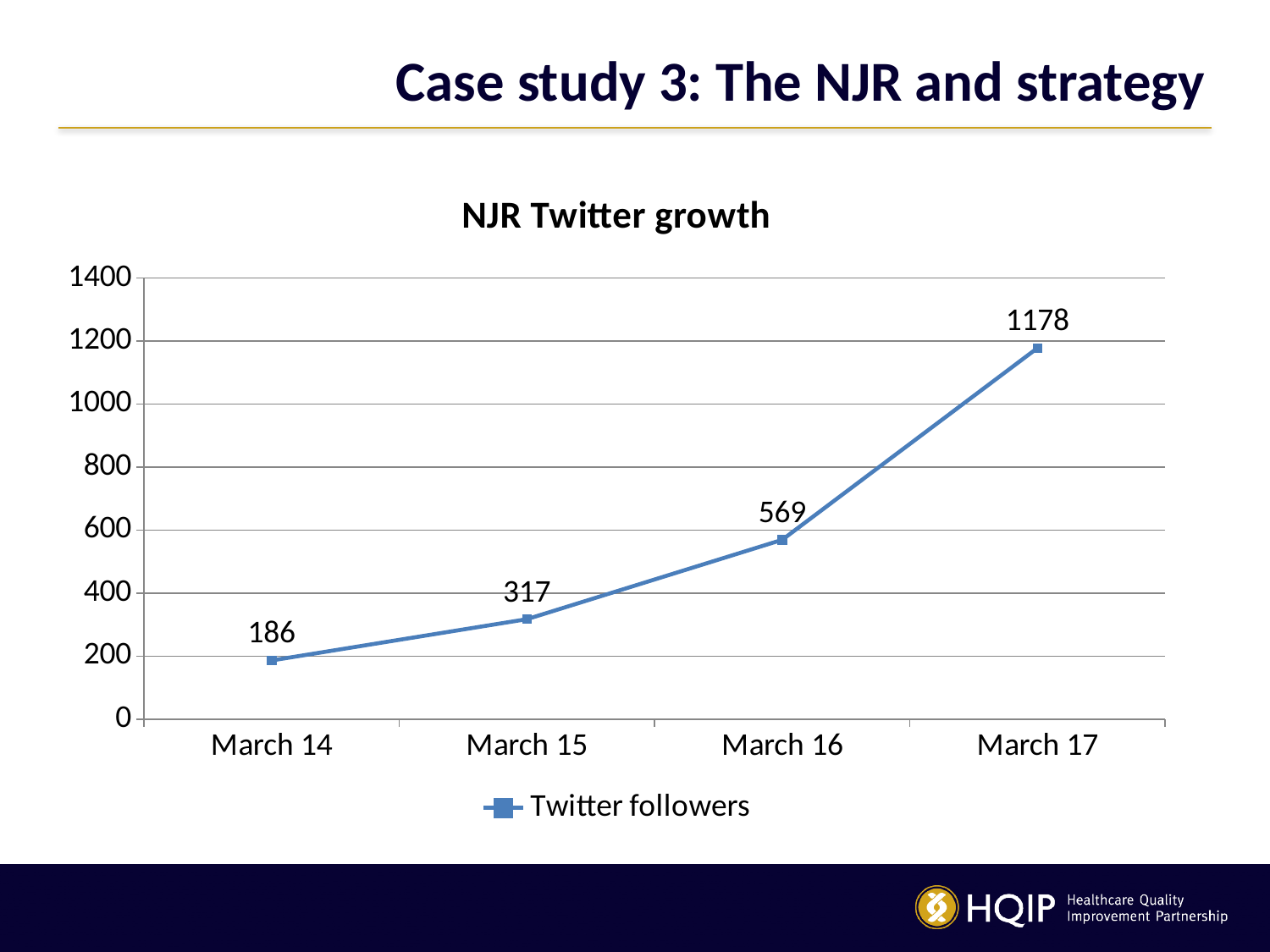
Do the values rise or fall from March 14 to March 17? rise Is the value for March 16 greater or less than 600? less How many data points are plotted on the chart? 4 Which is larger, the value for March 15 or the value for March 16? March 16 What is the difference in Twitter followers between March 17 and March 16? 609 Which point on the x axis has the lowest number of Twitter followers? March 14 What is the value for Twitter followers in March 17? 1178 Which point on the x axis has the highest number of Twitter followers? March 17 What is the value for Twitter followers in March 14? 186 What kind of chart is shown on the slide? line chart What is the value for Twitter followers in March 16? 569 What is the difference in Twitter followers between March 15 and March 14? 131